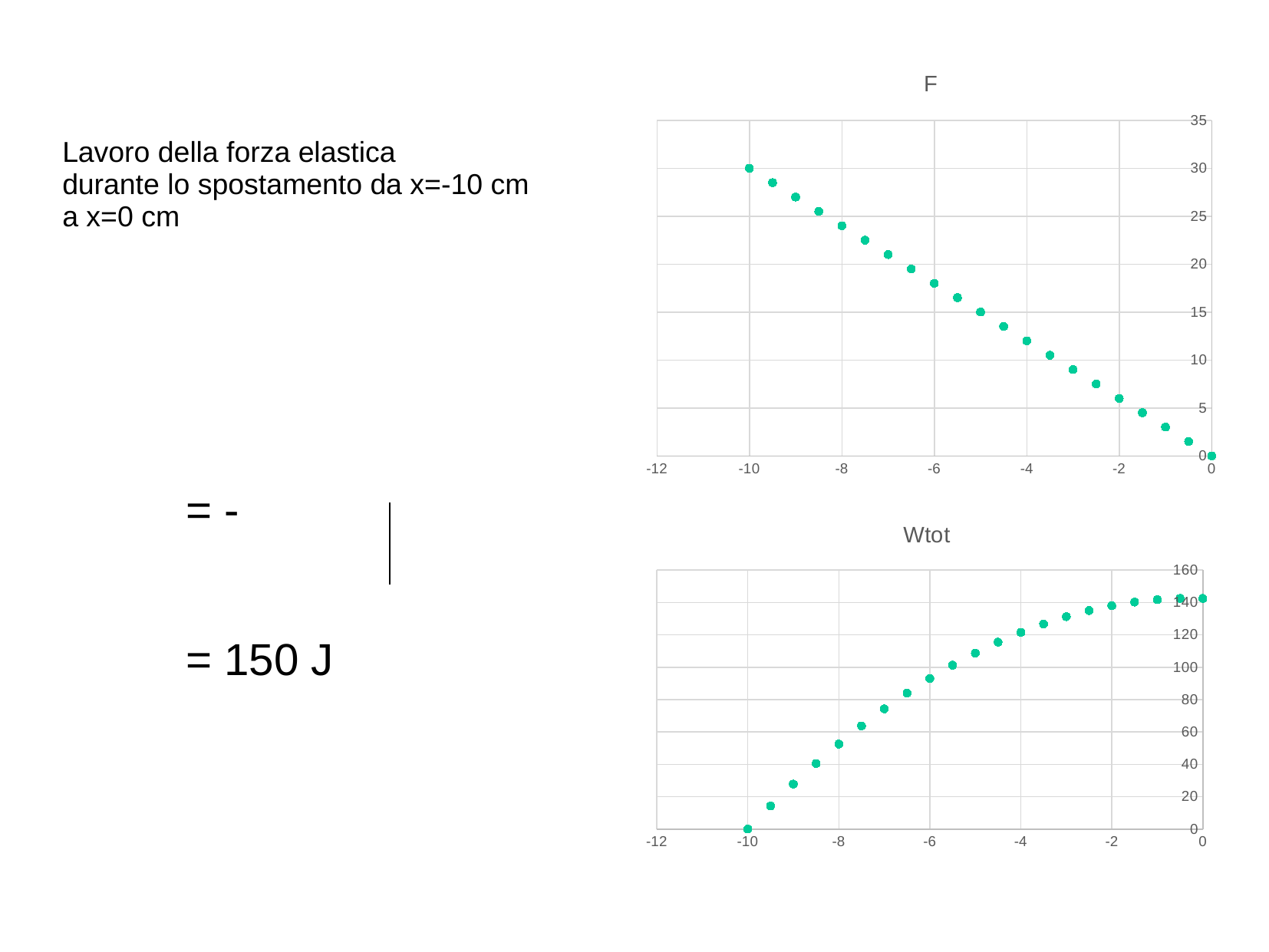
What kind of chart is the chart titled "F"? scatter chart In the chart titled "F", what is the value at x = -10? 30 How many data points are plotted in the chart titled "F"? 21 In the chart titled "Wtot", what is the value at x = -10? 0 In the chart titled "F", is the value at x = -6 greater or less than 15? greater In the chart titled "F", at which x value is the plotted value highest? -10 In the chart titled "F", is the value at x = -8 greater or less than 25? less In the chart titled "F", what is the value at x = 0? 0 In the chart titled "Wtot", is the value at x = -8 greater or less than 60? less In the chart titled "Wtot", do the values rise or fall as x increases from -10 to 0? rise In the chart titled "F", do the values rise or fall as x increases from -10 to 0? fall